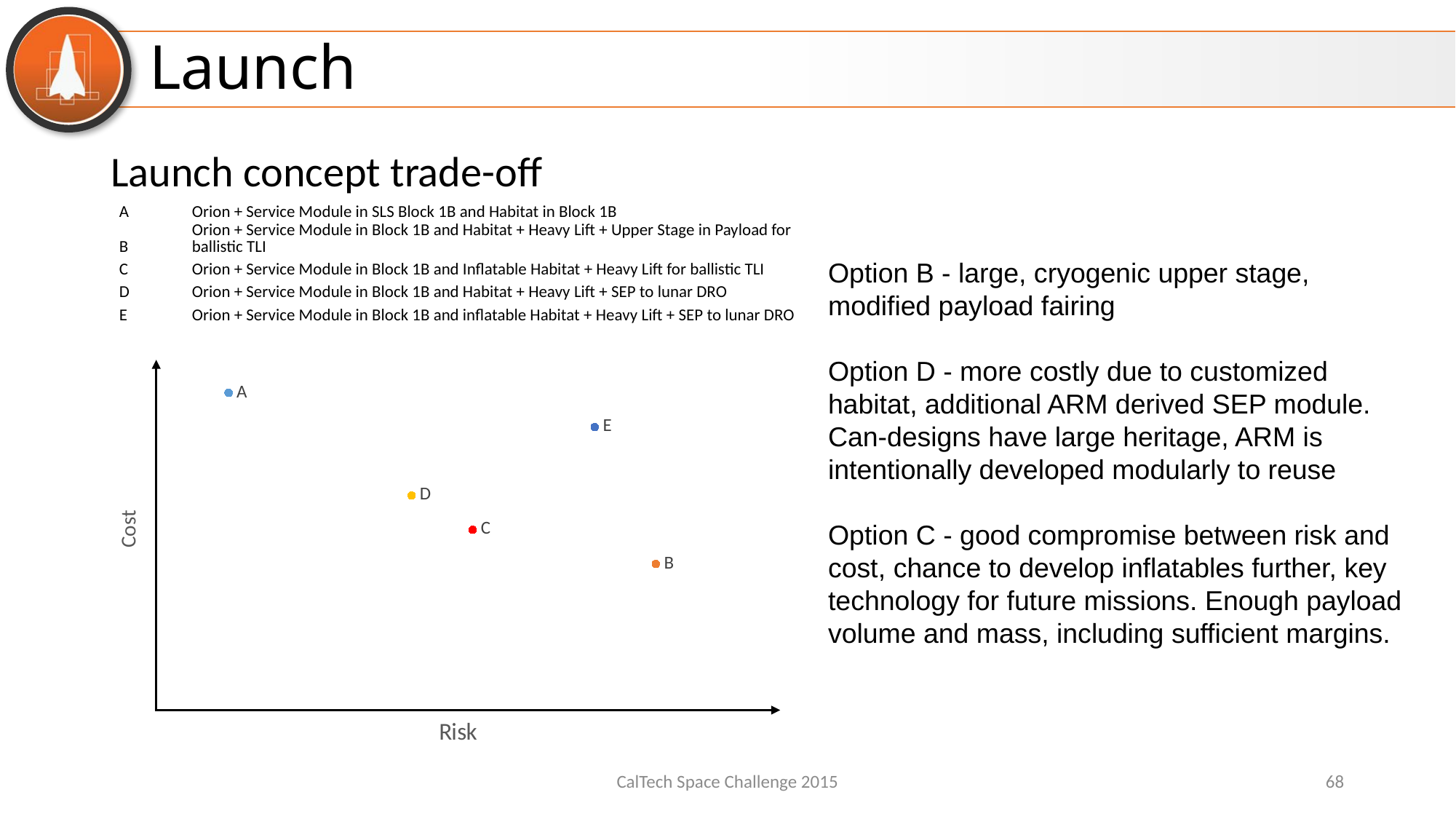
Which option has the highest risk on the chart? B Which option has the higher cost, E or C? E How many data points are plotted on the chart? 5 Which option has the lowest cost on the chart? B Which option has the higher risk, E or B? B What is the label of the horizontal axis of the chart? Risk Which option has the lowest risk on the chart? A Which option has the higher cost, C or D? D What is the label of the vertical axis of the chart? Cost What kind of chart is shown on the slide? Scatter chart Which option has the highest cost on the chart? A